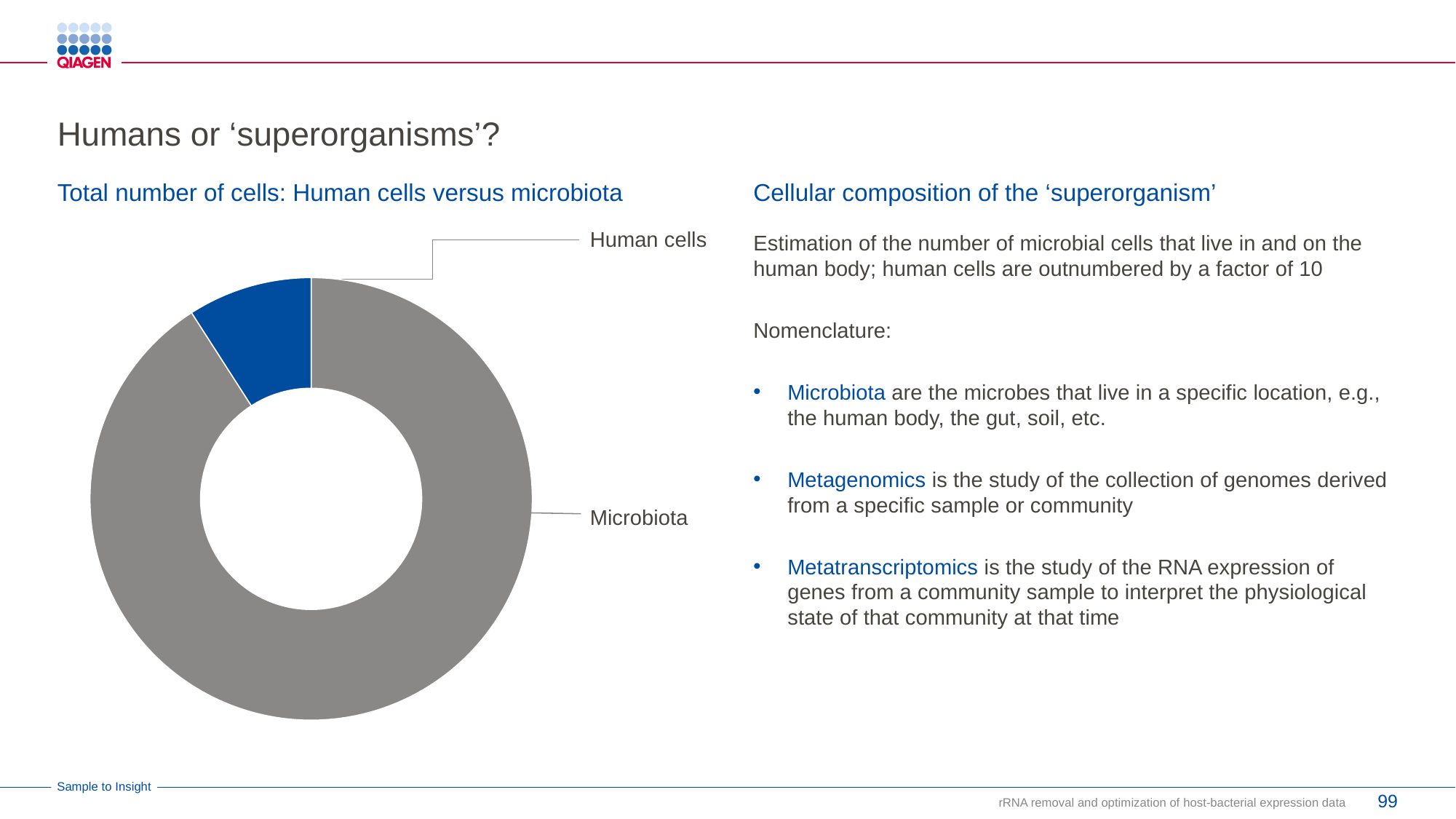
What is the title of the chart? Total number of cells: Human cells versus microbiota Which category has the smallest slice in the chart? Human cells What colour is the Human cells slice in the chart? blue Which slice is larger, Human cells or Microbiota? Microbiota Which category has the largest slice in the chart? Microbiota How many categories does the chart show? 2 What kind of chart is shown on the slide? doughnut chart